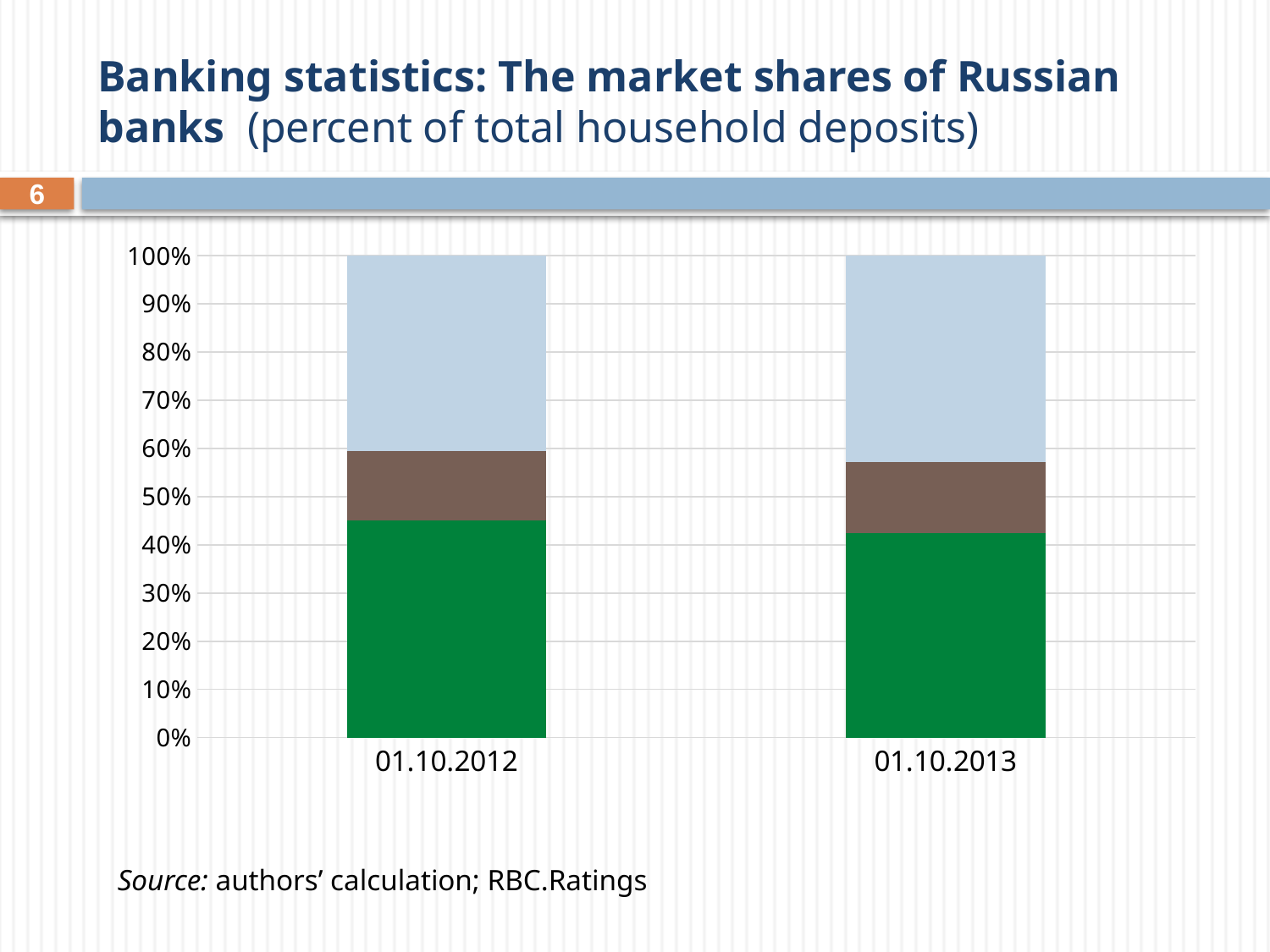
According to the slide, what is the source of the chart data? authors' calculation; RBC.Ratings What is the total height of the stacked bar for 01.10.2012? 100% How many dates (categories) are shown on the x axis of the chart? 2 What kind of chart is shown on the slide? Stacked bar chart How many coloured segments make up each bar in the chart? 3 Is the green (bottom) segment for 01.10.2012 greater or less than 40%? greater What is the total height of the stacked bar for 01.10.2013? 100% Is the green (bottom) segment for 01.10.2012 greater or less than 50%? less Does the green (bottom) segment rise or fall from 01.10.2012 to 01.10.2013? fall Which date has the larger green (bottom) segment, 01.10.2012 or 01.10.2013? 01.10.2012 What are the two category labels on the x axis of the chart? 01.10.2012 and 01.10.2013 Is the top of the brown (middle) segment for 01.10.2013 above or below the 60% gridline? below